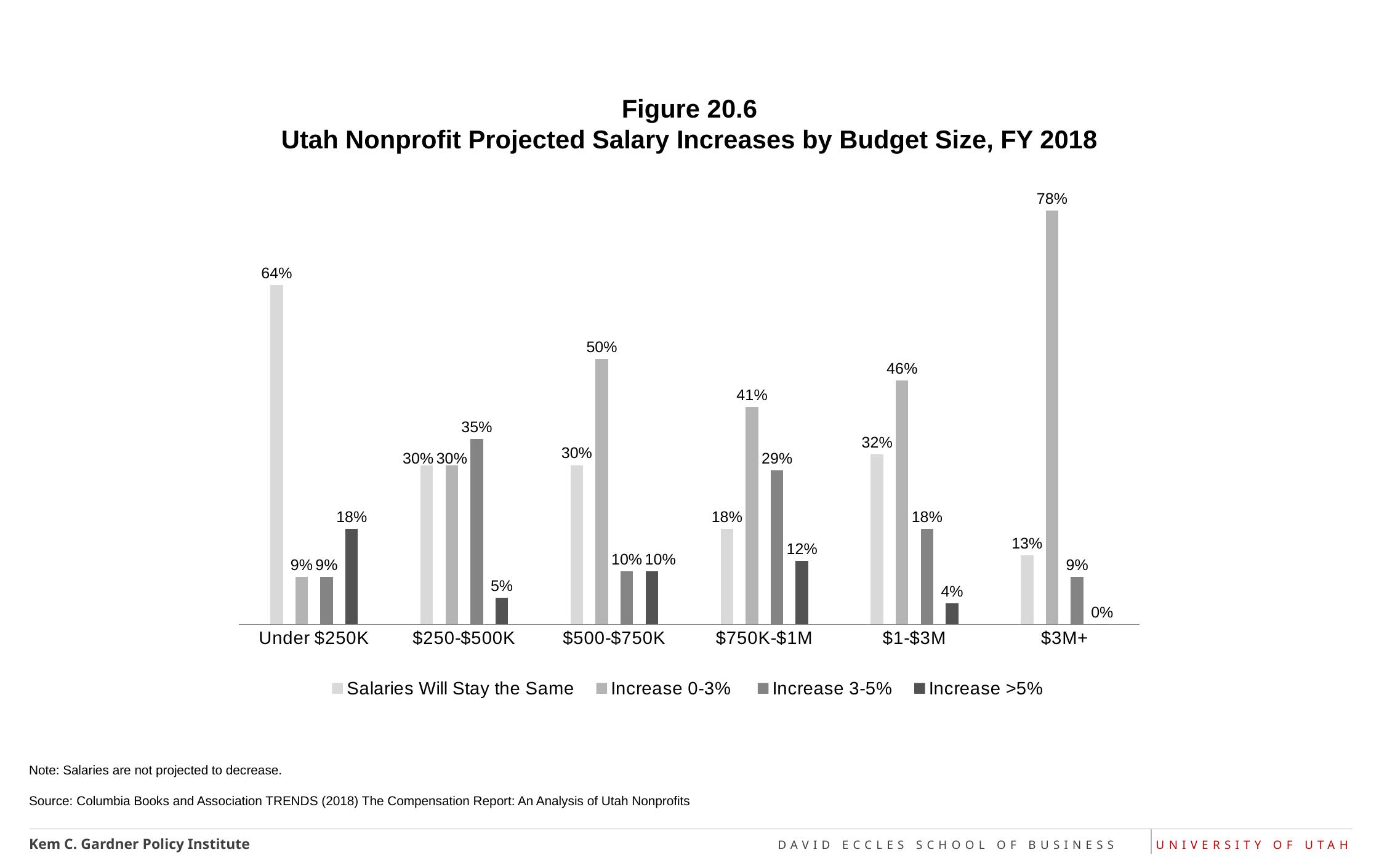
For the $750K-$1M category, which is larger: Increase 3-5% or Increase >5%? Increase 3-5% What is the difference between the Increase 0-3% value and the Salaries Will Stay the Same value for the $500-$750K category? 20% What is the title of the chart? Figure 20.6 Utah Nonprofit Projected Salary Increases by Budget Size, FY 2018 Which budget size category has the lowest value for Increase >5%? $3M+ What percentage of nonprofits with budgets under $250K project that salaries will stay the same? 64% What is the value for Increase 0-3% in the $3M+ budget category? 78% Which budget size category has the highest value for Increase 0-3%? $3M+ How does the Salaries Will Stay the Same value change from Under $250K to $250-$500K? It falls from 64% to 30% How many series does the legend list? 4 What kind of chart is shown on the slide? Bar chart What is the value for Increase >5% in the $250-$500K budget category? 5% How many budget size categories are shown on the x axis? 6